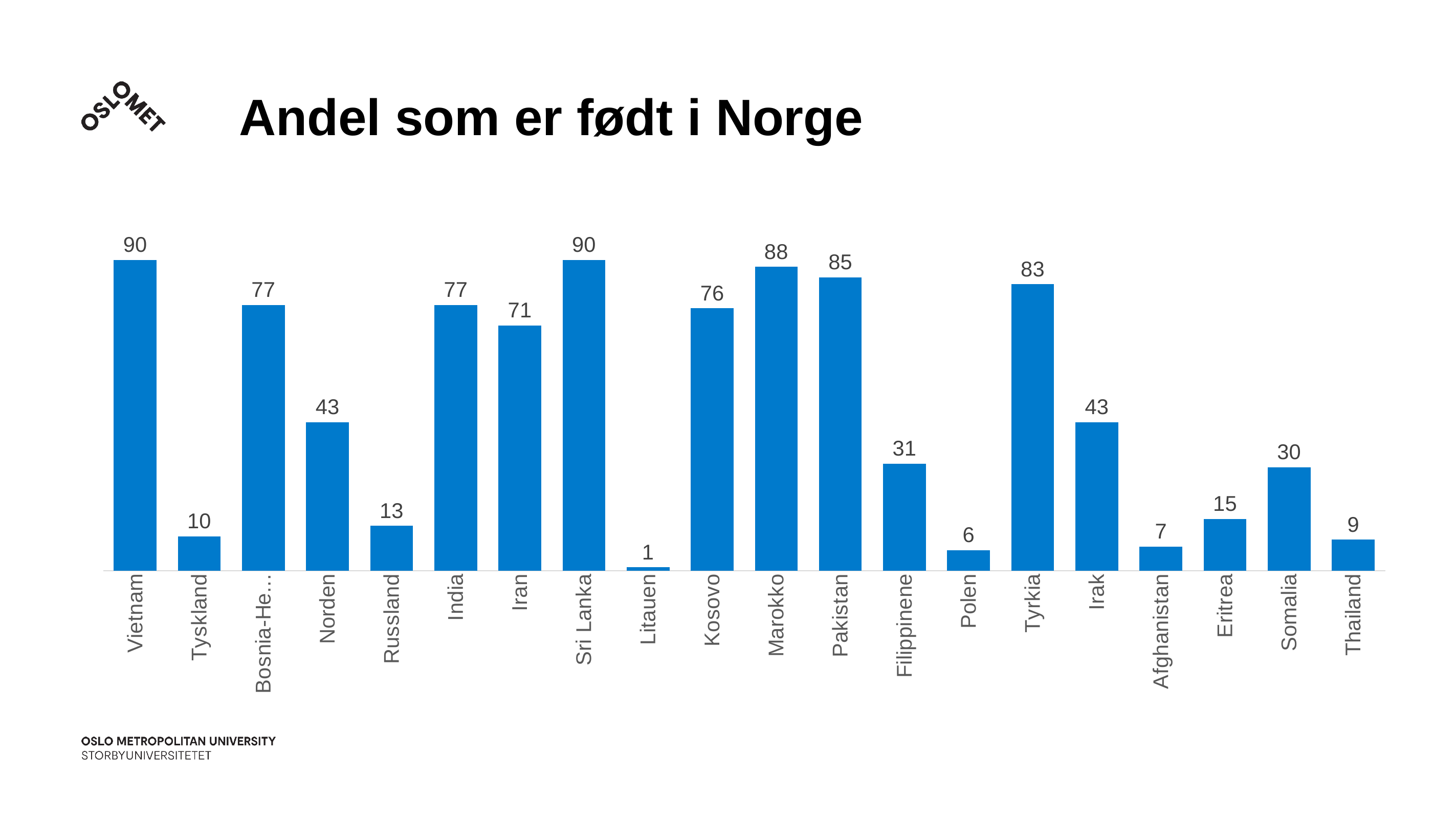
Which category has the lowest value? Litauen What kind of chart is shown on the slide? Bar chart What is the value for Tyrkia? 83 What is the value for Somalia? 30 What is the difference between the values for Iran and Eritrea? 56 Which is larger, the value for Polen or the value for Russland? Russland How many categories are shown on the x axis? 20 What is the value for Pakistan? 85 What is the title of the chart? Andel som er født i Norge Which is larger, the value for Kosovo or the value for Irak? Kosovo What is the difference between the values for Marokko and Filippinene? 57 What is the value for Litauen? 1